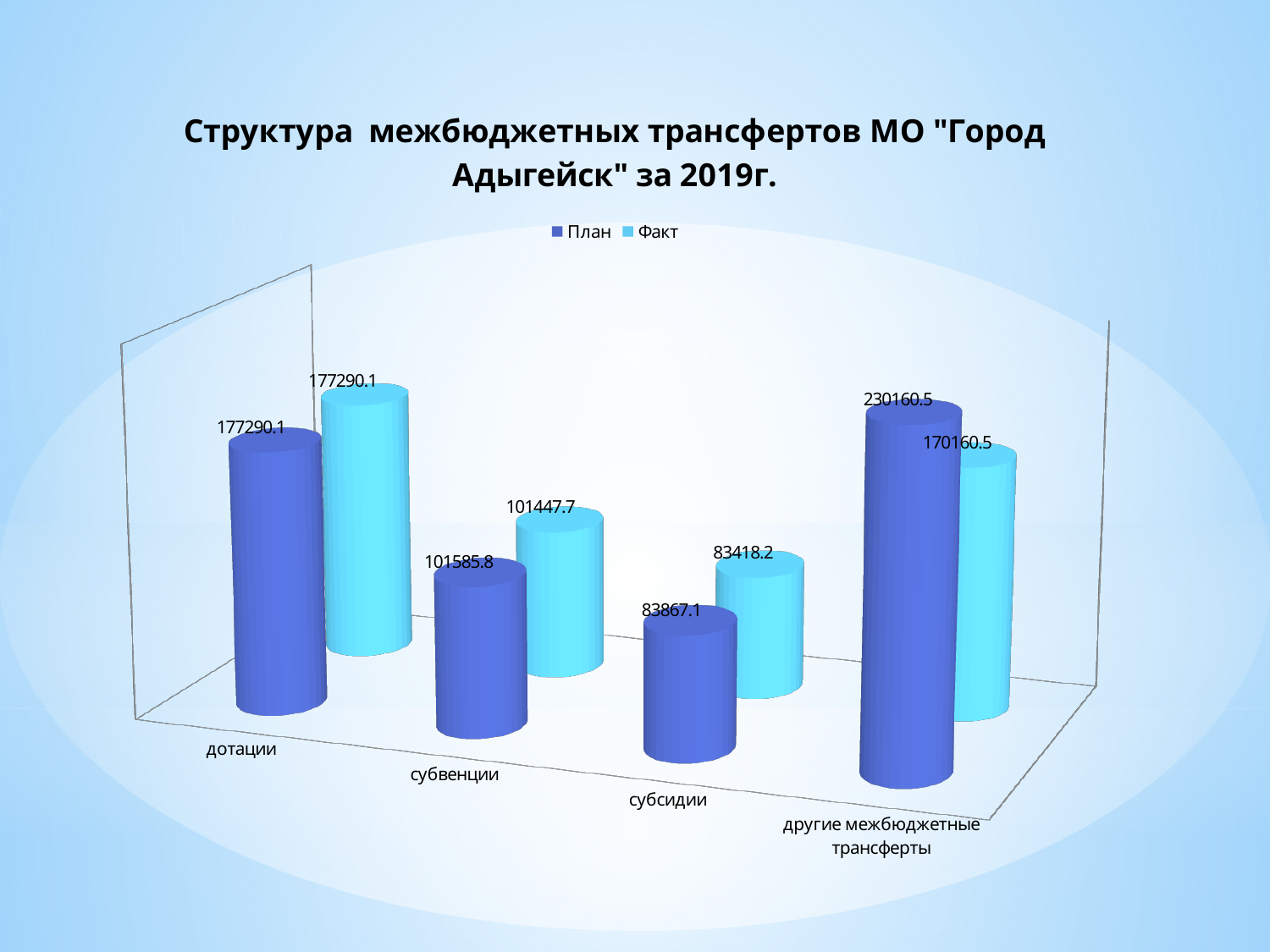
Which category has the highest План value? другие межбюджетные трансферты What is the План value for дотации? 177290.1 How many series does the legend list? 2 Which is larger for субсидии, the План value or the Факт value? План Which category has the highest Факт value? дотации What is the План value for другие межбюджетные трансферты? 230160.5 Which category has the lowest Факт value? субсидии How many categories are shown on the chart? 4 What kind of chart is shown on the slide? bar chart What is the Факт value for субсидии? 83418.2 What is the Факт value for субвенции? 101447.7 What is the difference between the План and Факт values for другие межбюджетные трансферты? 60000.0